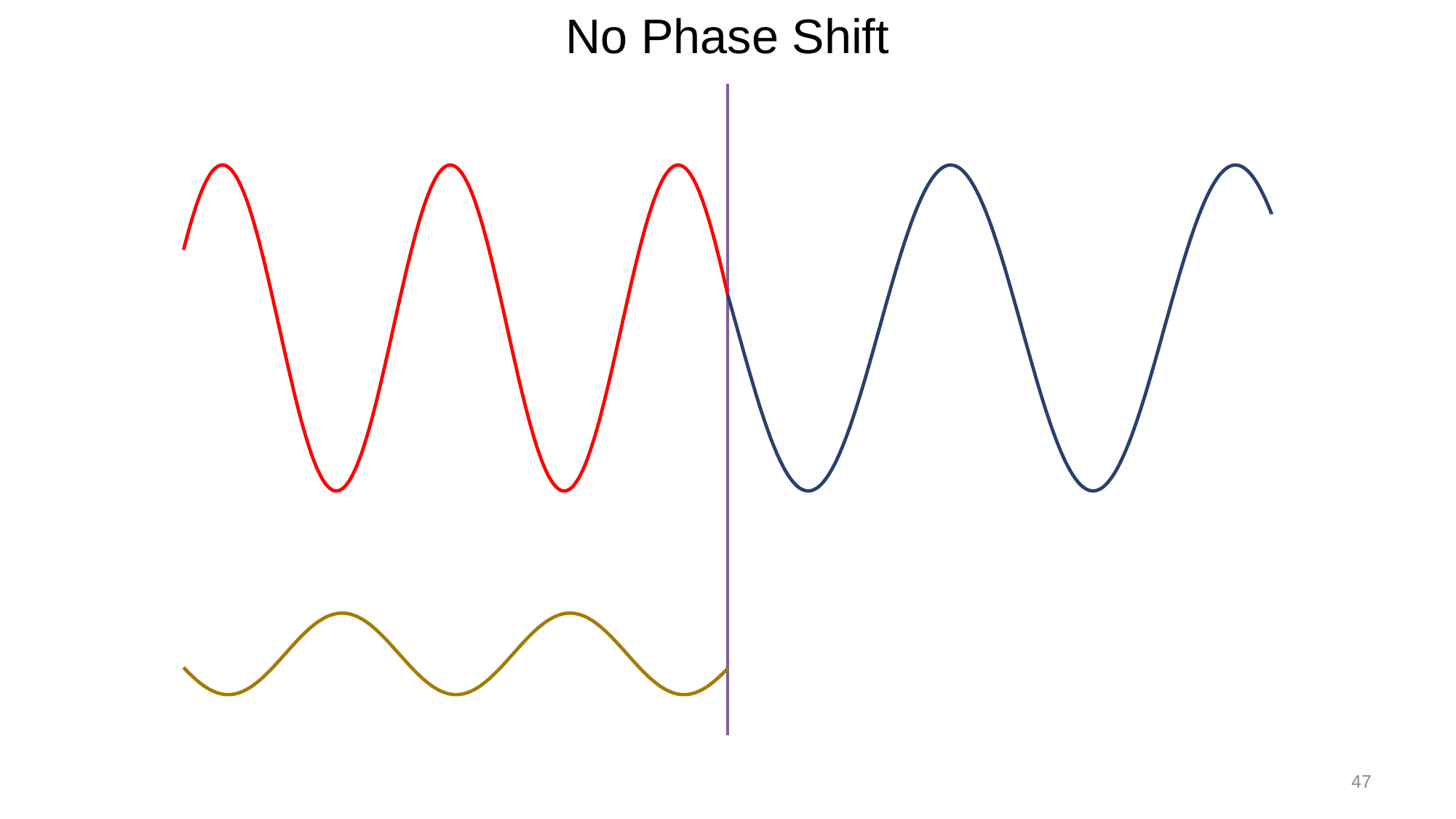
What colour is the wave drawn to the right of the vertical purple line? blue What kind of chart is shown on the slide? line chart What is the title of the chart on the slide? No Phase Shift How many wave curves are drawn on the slide? 3 Which wave has the larger amplitude, the red wave or the gold wave? red